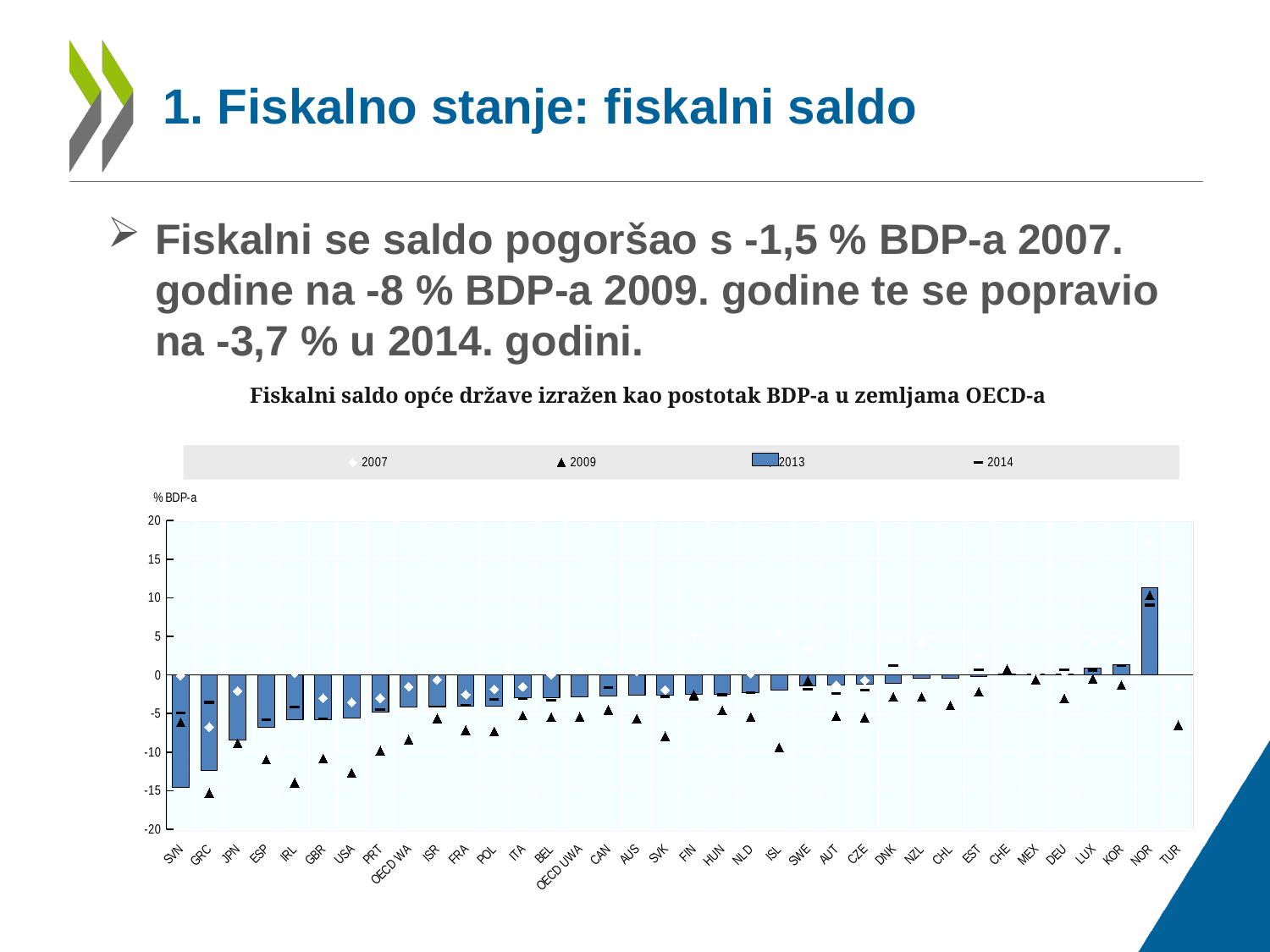
Do the 2013 bars generally rise or fall moving from left to right along the x axis? rise What kind of chart is shown on the slide? bar chart Is the 2013 value for NOR greater or less than 5? greater Which category has the highest 2013 bar in the chart? NOR How many countries/categories are shown along the x axis of the chart? 36 Which category has the lowest 2013 bar in the chart? SVN How many series does the chart legend list? 4 What is the title of the chart? Fiskalni saldo opće države izražen kao postotak BDP-a u zemljama OECD-a Is the 2013 value for SVN greater or less than -10? less Is the 2009 value for IRL greater or less than -10? less Which has the larger 2013 value, SVN or GRC? GRC Which years are listed in the chart legend? 2007, 2009, 2013, 2014